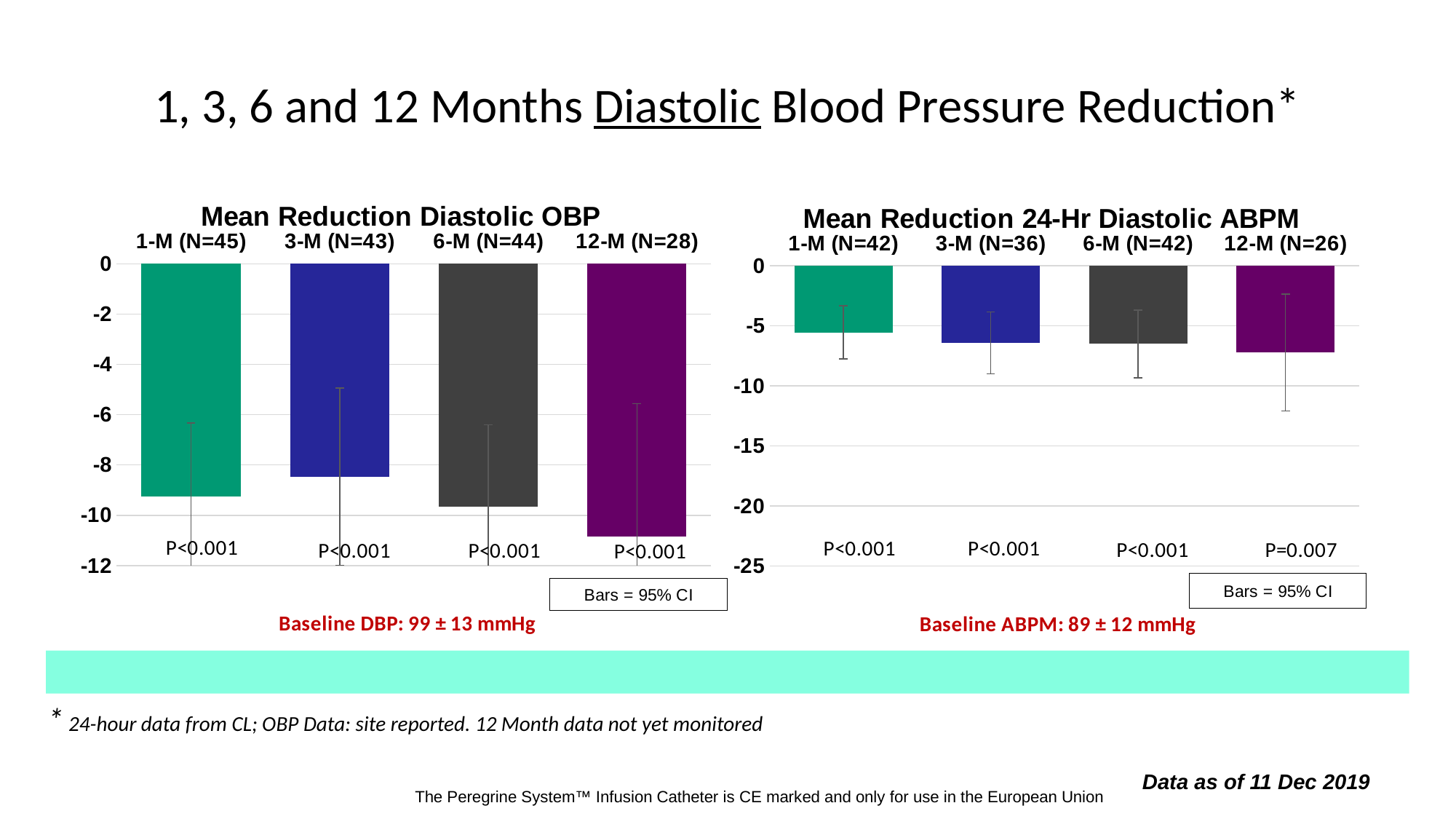
In the 'Mean Reduction 24-Hr Diastolic ABPM' chart, is the value for 12-M (N=26) greater or less than -5? less In the 'Mean Reduction Diastolic OBP' chart, which is lower (more negative): the value for 1-M (N=45) or 3-M (N=43)? 1-M (N=45) What baseline value is stated below the 'Mean Reduction Diastolic OBP' chart? Baseline DBP: 99 ± 13 mmHg In the 'Mean Reduction 24-Hr Diastolic ABPM' chart, is the value for 1-M (N=42) greater or less than -10? greater What P-value is shown for 12-M (N=26) in the 'Mean Reduction 24-Hr Diastolic ABPM' chart? P=0.007 How many bars are shown in the 'Mean Reduction 24-Hr Diastolic ABPM' chart? 4 In the 'Mean Reduction Diastolic OBP' chart, is the value for 3-M (N=43) greater or less than -10? greater In the 'Mean Reduction Diastolic OBP' chart, which category has the lowest (most negative) value? 12-M (N=28) In the 'Mean Reduction Diastolic OBP' chart, which category has the highest (least negative) value? 3-M (N=43) What type of chart is the 'Mean Reduction Diastolic OBP' chart? bar chart In the 'Mean Reduction 24-Hr Diastolic ABPM' chart, which category has the highest (least negative) value? 1-M (N=42)